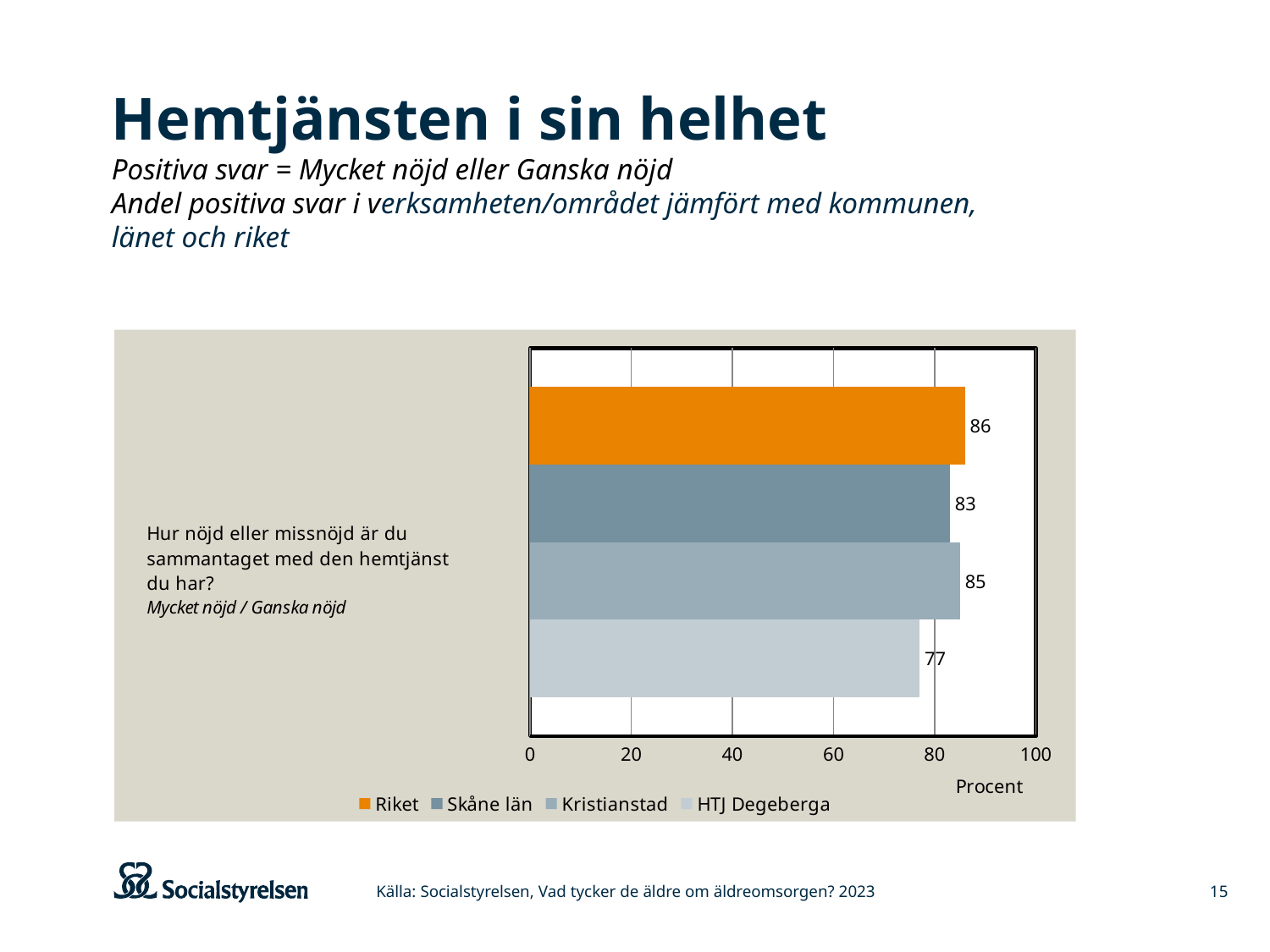
What is the value for Kristianstad? 85 What is the value for Skåne län? 83 What is the value for HTJ Degeberga? 77 What is the value for Riket? 86 How many series does the legend list? 4 What kind of chart is shown on the slide? Bar chart What is the difference between the values for Kristianstad and Skåne län? 2 Which is larger, the value for Kristianstad or the value for HTJ Degeberga? Kristianstad Which series has the lowest value? HTJ Degeberga What unit is shown on the x axis of the chart? Procent What is the difference between the values for Riket and HTJ Degeberga? 9 Which series has the highest value? Riket